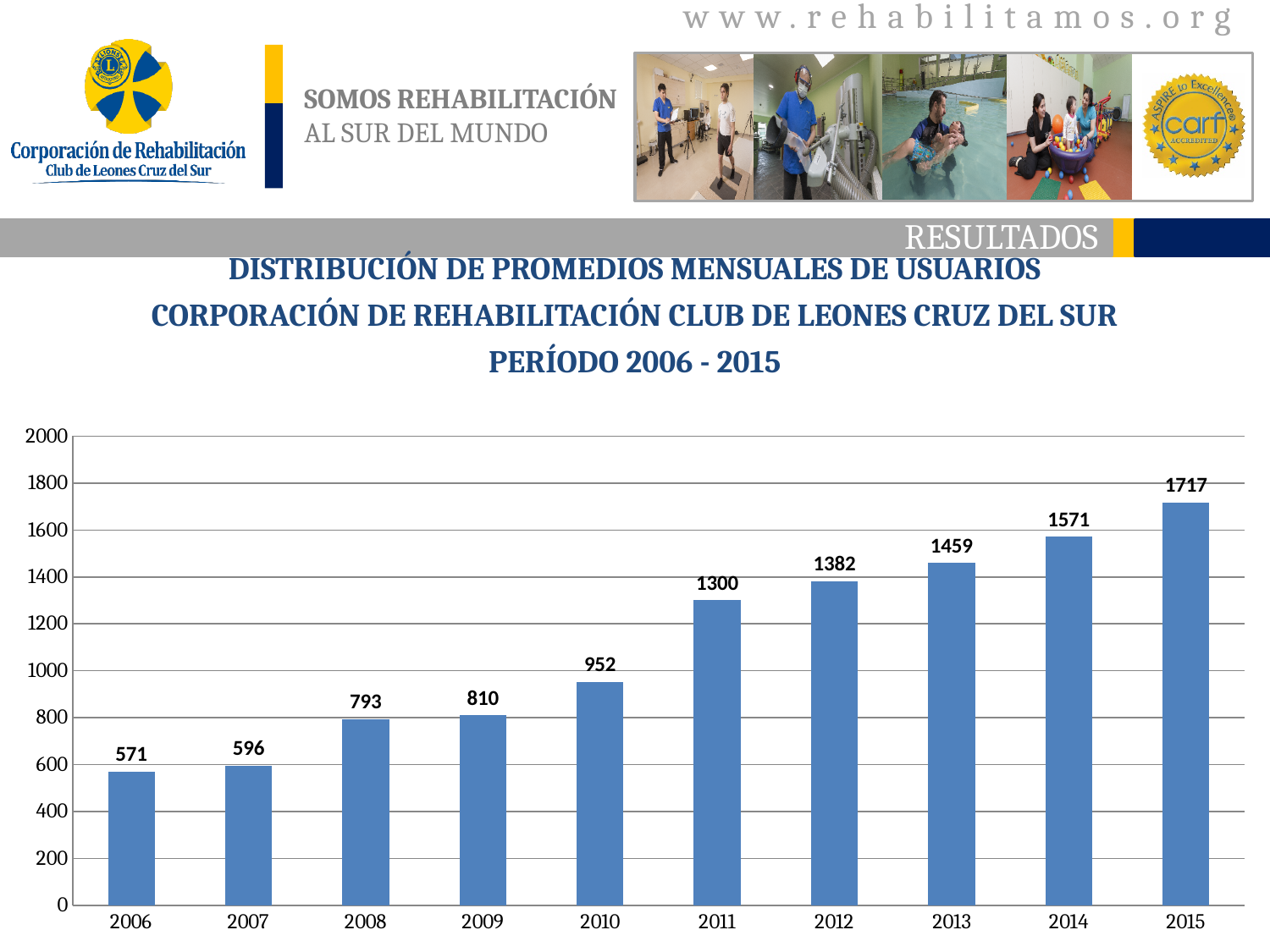
What is the difference between the values for 2015 and 2014? 146 What kind of chart is shown on the slide? bar chart What is the difference between the values for 2011 and 2010? 348 What is the value for 2010? 952 Which is larger, the value for 2008 or the value for 2009? 2009 What is the value for 2006? 571 Is the value for 2012 greater or less than 1200? greater Which year has the lowest value? 2006 Which year has the highest value? 2015 Do the values rise or fall from 2006 to 2015? rise How many years are shown on the x axis? 10 What is the value for 2013? 1459